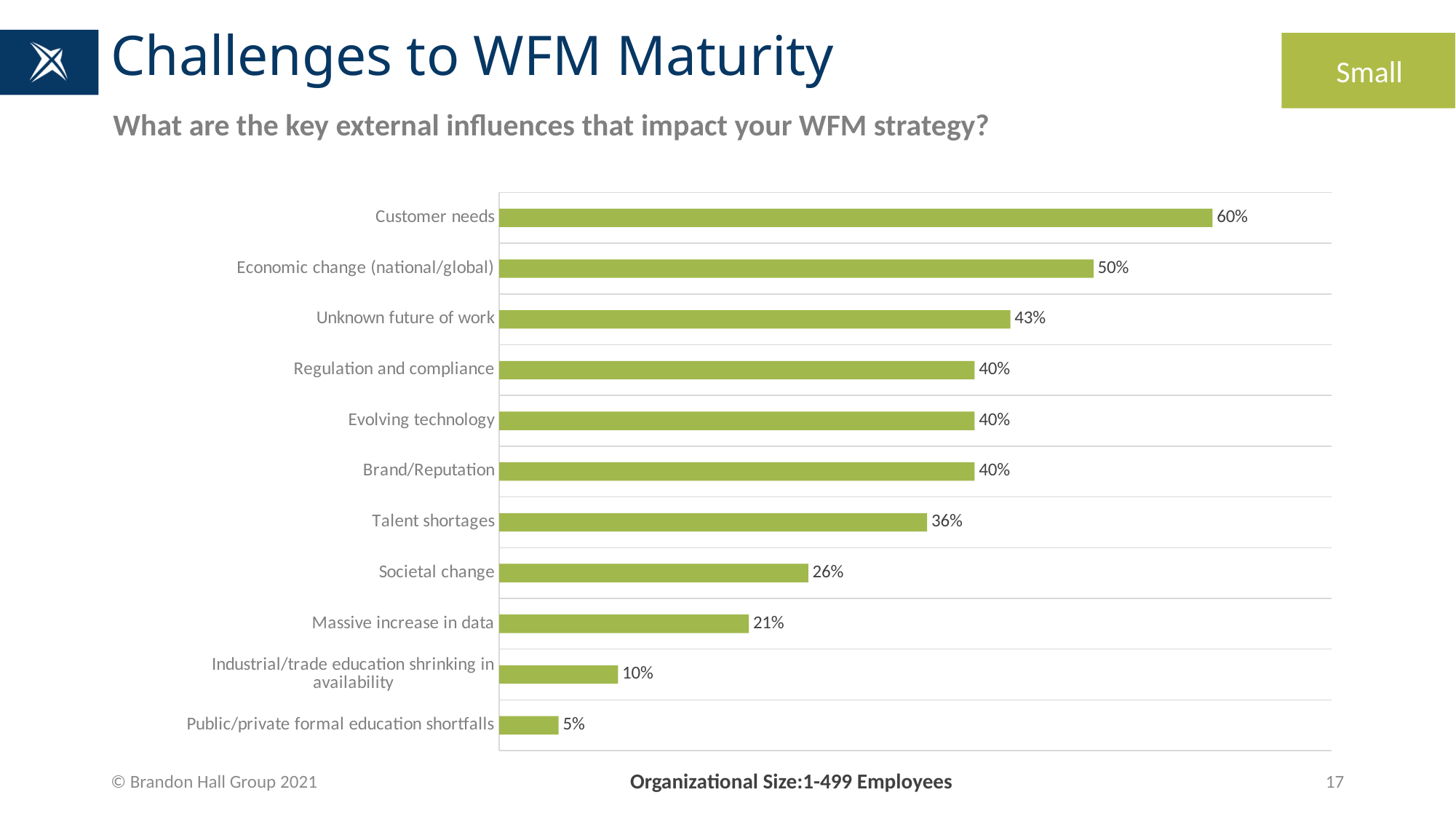
Which category has the lowest value? Public/private formal education shortfalls What is the value for Talent shortages? 36% How many categories share the value 40%? 3 Which category has the highest value? Customer needs Which is larger, Unknown future of work or Talent shortages? Unknown future of work What is the difference between Societal change and Massive increase in data? 5% What is the difference between Customer needs and Economic change (national/global)? 10% What percentage is shown for Customer needs? 60% What percentage is shown for Industrial/trade education shrinking in availability? 10% What organizational size does the chart cover, according to the footer? 1-499 Employees What kind of chart is shown on the slide? Bar chart How many categories are shown in the chart? 11